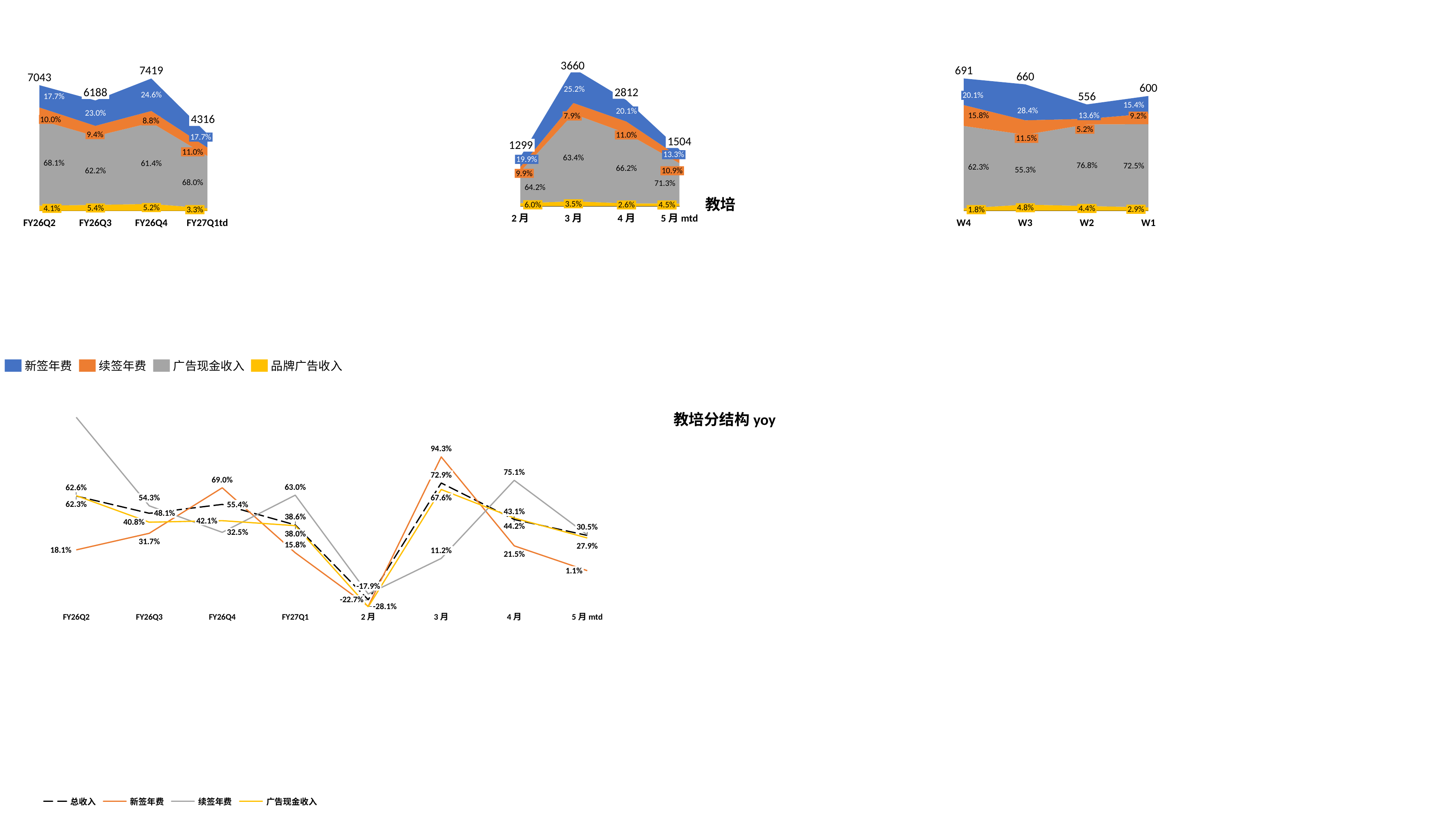
In the top-middle chart, what is the total value for 3月? 3660 In the top-right chart, is the total for W3 larger or smaller than the total for W1? larger In the bottom chart titled 教培分结构 yoy, what is the value of 新签年费 for 3月? 94.3% How many series does the legend of the top stacked area charts list? 4 In the top-left chart, what share does 广告现金收入 have in FY26Q2? 68.1% In the top-middle chart, what is the difference between the totals for 3月 and 4月? 848 In the top-right chart, what share does 续签年费 have in W2? 5.2% In the bottom chart titled 教培分结构 yoy, what is the value of 续签年费 for 4月? 75.1% In the top-middle chart, what share does 新签年费 have in 5月 mtd? 13.3% In the top-left chart, which period has the lowest total value? FY27Q1td In the top-left chart, what is the total value shown for FY26Q4? 7419 In the top-right chart, which week has the highest total value? W4